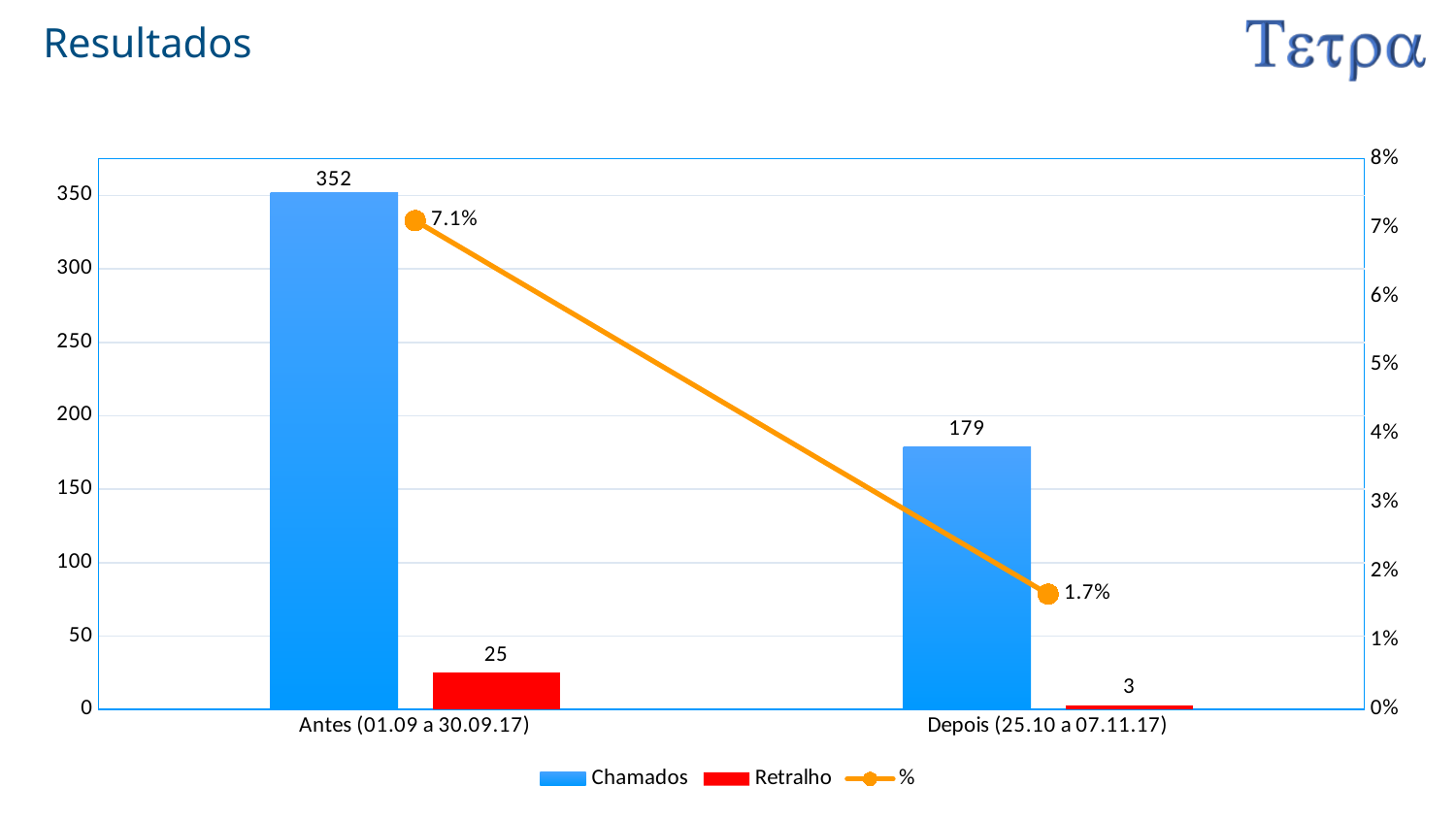
How many categories are shown on the x axis? 2 What is the value of Retralho for Depois (25.10 a 07.11.17)? 3 Which category has the higher Chamados value? Antes (01.09 a 30.09.17) How many series does the legend list? 3 Which category has the lowest Retralho value? Depois (25.10 a 07.11.17) What is the difference in Retralho between Antes (01.09 a 30.09.17) and Depois (25.10 a 07.11.17)? 22 Is the Retralho value for Antes (01.09 a 30.09.17) larger or smaller than the Retralho value for Depois (25.10 a 07.11.17)? larger What is the value of Chamados for Antes (01.09 a 30.09.17)? 352 What is the difference in Chamados between Antes (01.09 a 30.09.17) and Depois (25.10 a 07.11.17)? 173 Does the % line rise or fall from Antes to Depois? fall What is the % value for Antes (01.09 a 30.09.17)? 7.1% What is the % value for Depois (25.10 a 07.11.17)? 1.7%